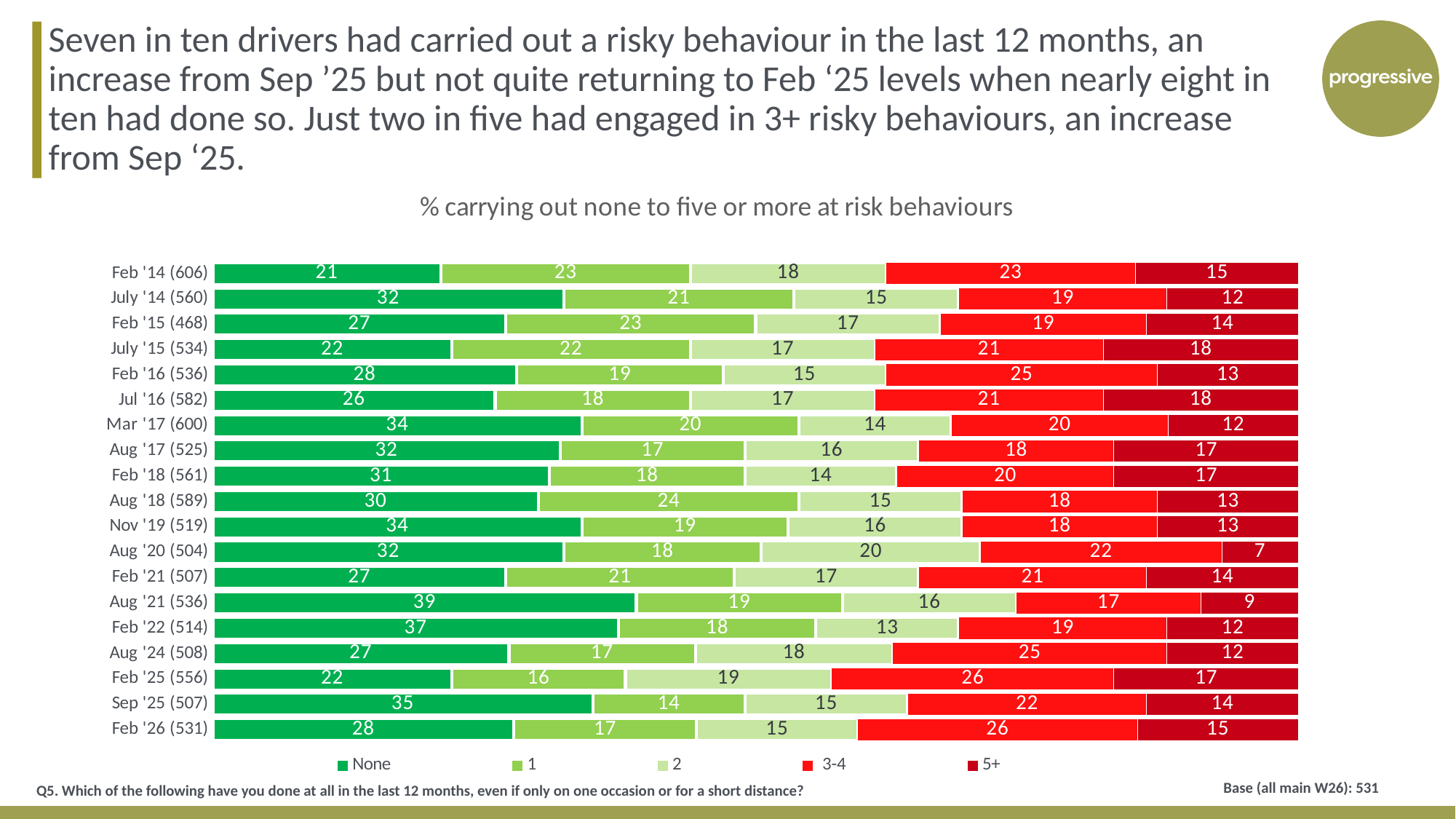
Which wave has the highest value for "None"? Aug '21 (536) What is the difference between the "None" values for Sep '25 (507) and Feb '26 (531)? 7 Which wave has the lowest value for the "5+" series? Aug '20 (504) What is the value for the "5+" series in the Aug '20 (504) bar? 7 Which wave has the larger "3-4" value, Sep '25 (507) or Feb '26 (531)? Feb '26 (531) How many waves (bars) are shown in the chart? 19 What is the value for "None" in the Feb '26 (531) bar? 28 What is the title of the chart? % carrying out none to five or more at risk behaviours What kind of chart is shown on the slide? Stacked bar chart What is the total of the Feb '14 (606) stacked bar? 100 How many series does the legend list? 5 What is the value for the "3-4" series in the Feb '25 (556) bar? 26